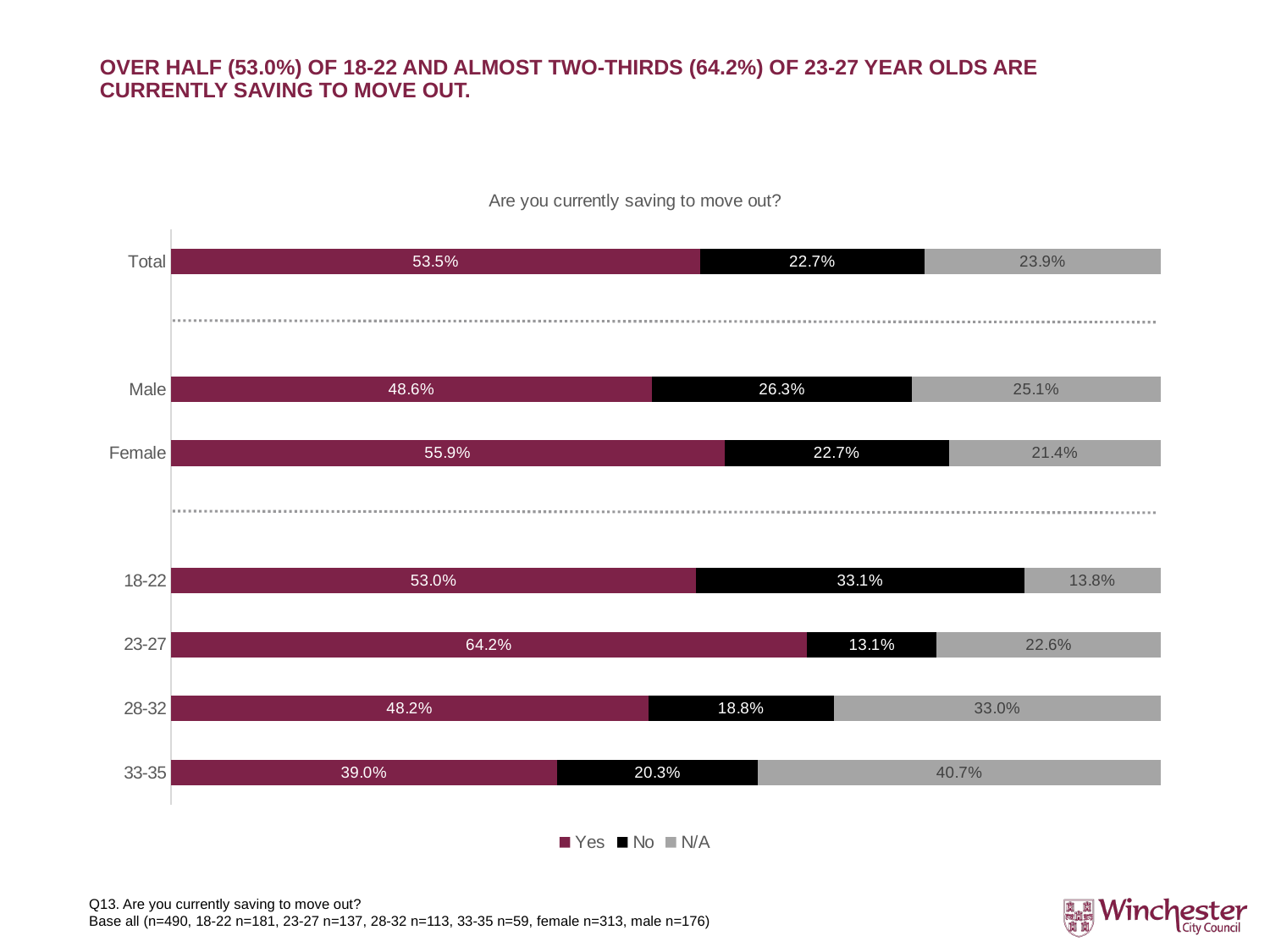
What kind of chart is shown on the slide? Stacked bar chart Which series is shown in black in the chart? No What is the title of the chart? Are you currently saving to move out? What percentage of the Total group answered Yes to currently saving to move out? 53.5% What is the difference between the Yes percentages for Female and Male? 7.3% How many series does the legend list? 3 Which category has the lowest Yes percentage? 33-35 What percentage of Males answered No? 26.3% Which category has the highest Yes percentage? 23-27 Which has a larger No percentage, 18-22 or 23-27? 18-22 How many categories are shown on the y axis of the chart? 7 What is the N/A value for the 33-35 age group? 40.7%